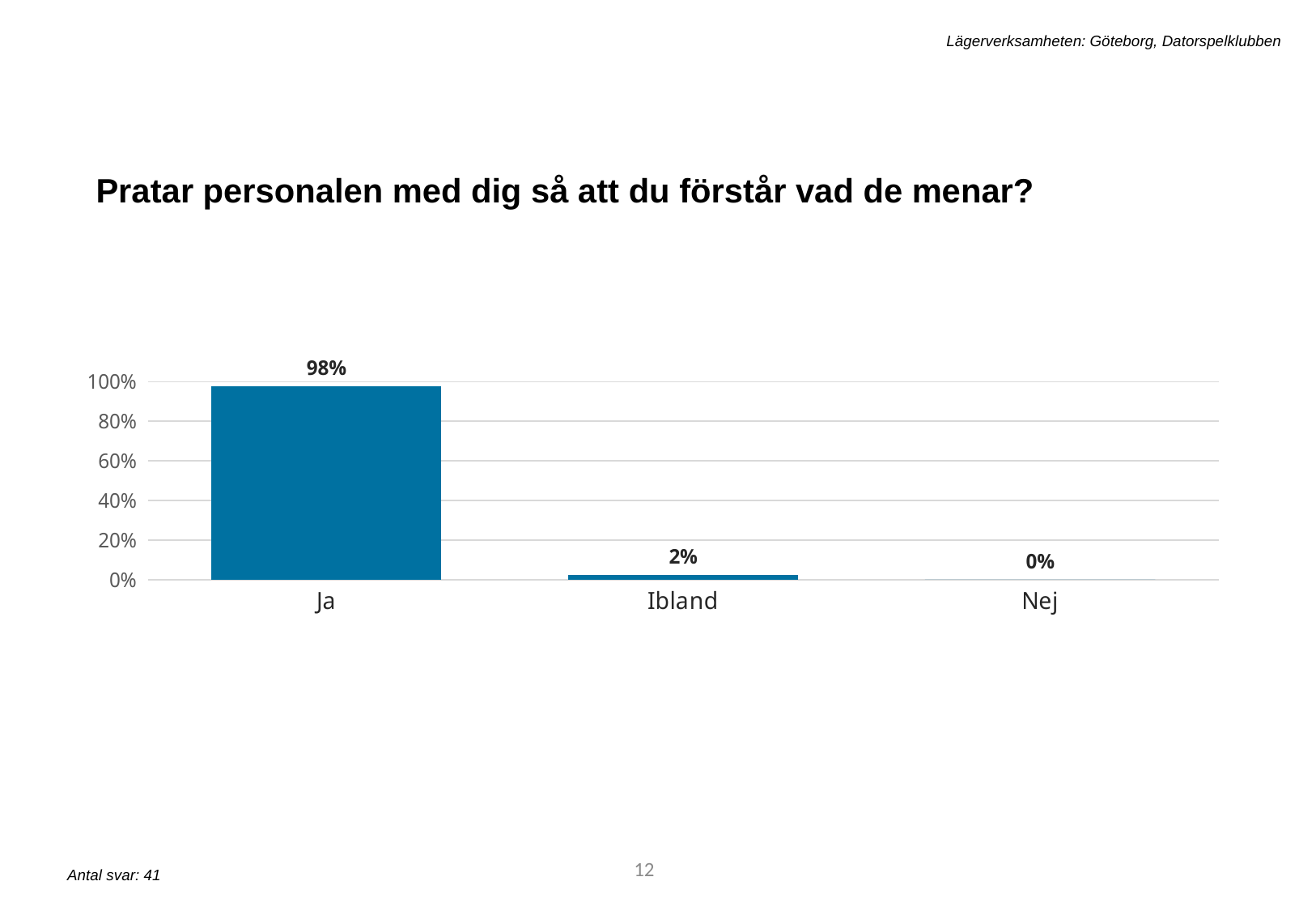
What is the value for Nej? 0% Which category has the lowest value? Nej What is the difference between the values for Ja and Ibland? 96% What is the value for Ja? 98% Do the values rise or fall from left to right along the x axis? fall Which category has the highest value? Ja Is the value for Ja greater or less than 80%? greater Which is larger, the value for Ibland or the value for Nej? Ibland What kind of chart is shown on the slide? bar chart How many categories are shown on the x axis? 3 What is the value for Ibland? 2% What is the question shown as the title above the chart? Pratar personalen med dig så att du förstår vad de menar?